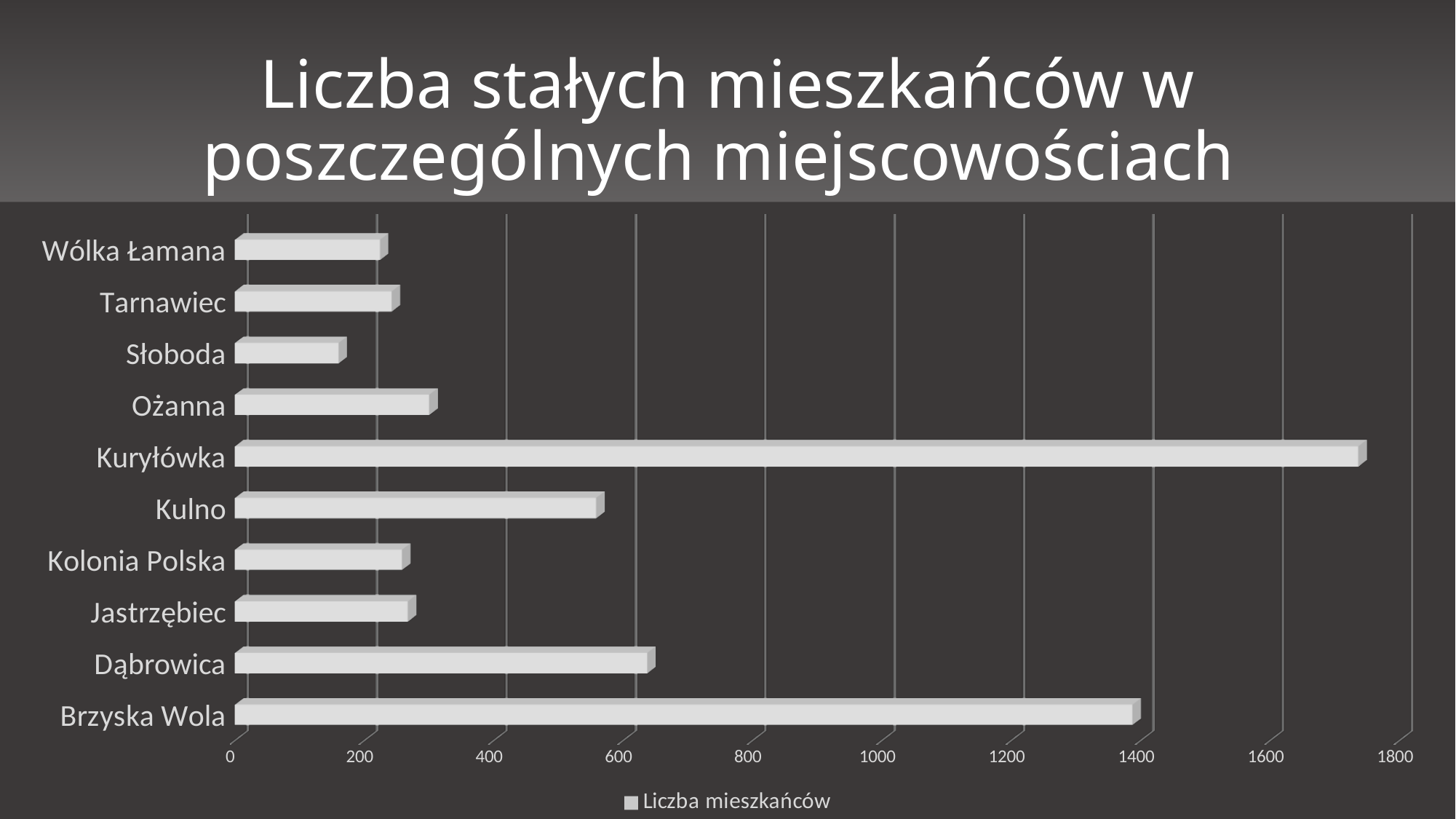
How many series does the legend list? 1 Which has more residents, Kulno or Dąbrowica? Dąbrowica Which locality has the lowest number of permanent residents? Słoboda Is the value for Kuryłówka greater or less than 1600? greater Is the value for Kulno greater or less than 400? greater What kind of chart is shown on the slide? bar chart Is the value for Brzyska Wola greater or less than 1200? greater Which locality has the highest number of permanent residents? Kuryłówka What is the series name shown in the legend? Liczba mieszkańców Which has more residents, Brzyska Wola or Dąbrowica? Brzyska Wola How many localities (categories) are shown on the chart? 10